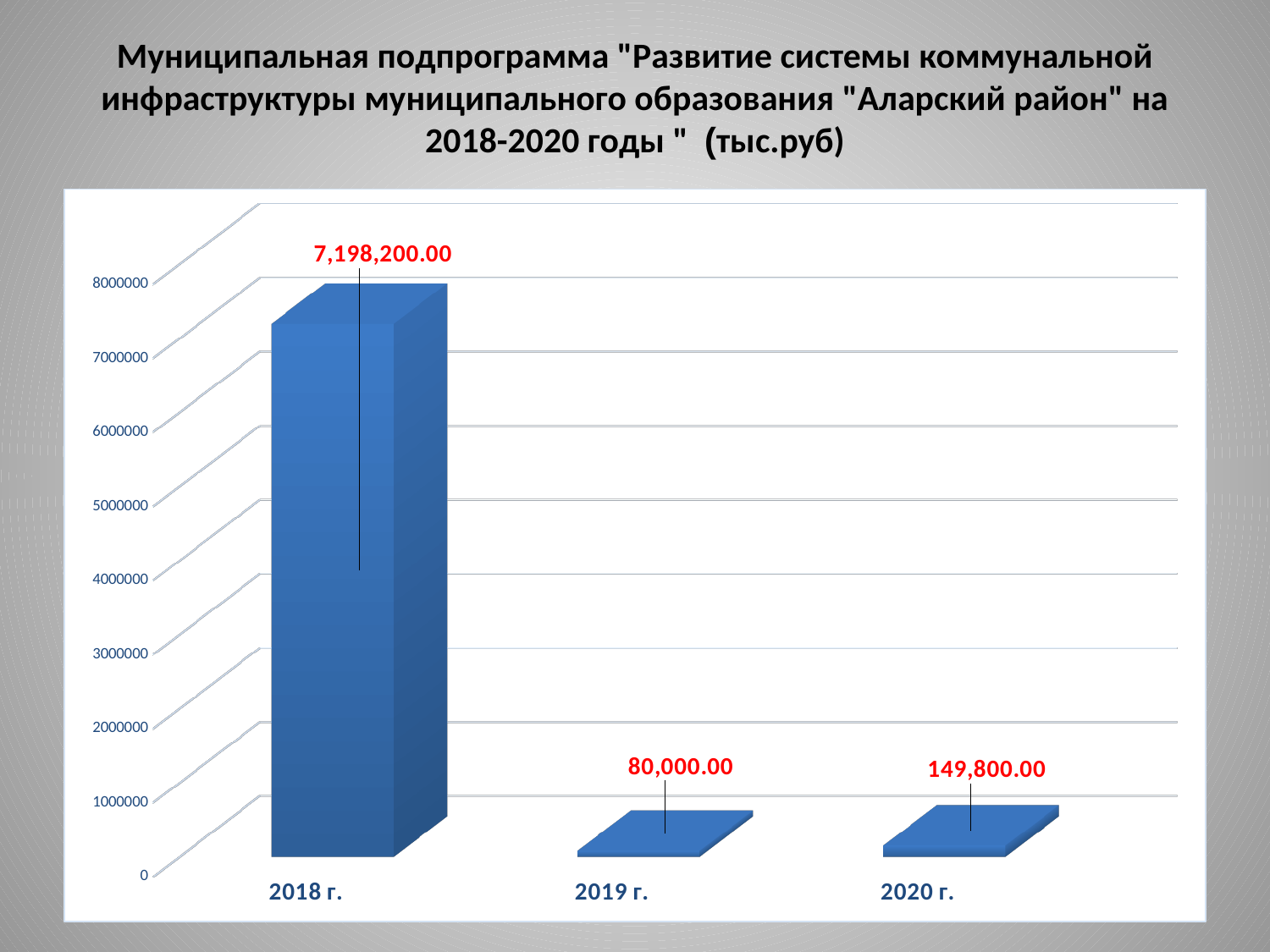
Which year has the highest value? 2018 г. Which year has the lowest value? 2019 г. What is the value for 2019 г.? 80,000.00 What is the difference between the values for 2018 г. and 2019 г.? 7,118,200.00 What kind of chart is shown on the slide? bar chart Is the value for 2018 г. greater or less than 7000000? greater What is the value for 2018 г.? 7,198,200.00 Does the value rise or fall from 2018 г. to 2019 г.? fall Which is larger, the value for 2019 г. or the value for 2020 г.? 2020 г. What is the value for 2020 г.? 149,800.00 How many years are shown on the chart? 3 What is the difference between the values for 2020 г. and 2019 г.? 69,800.00